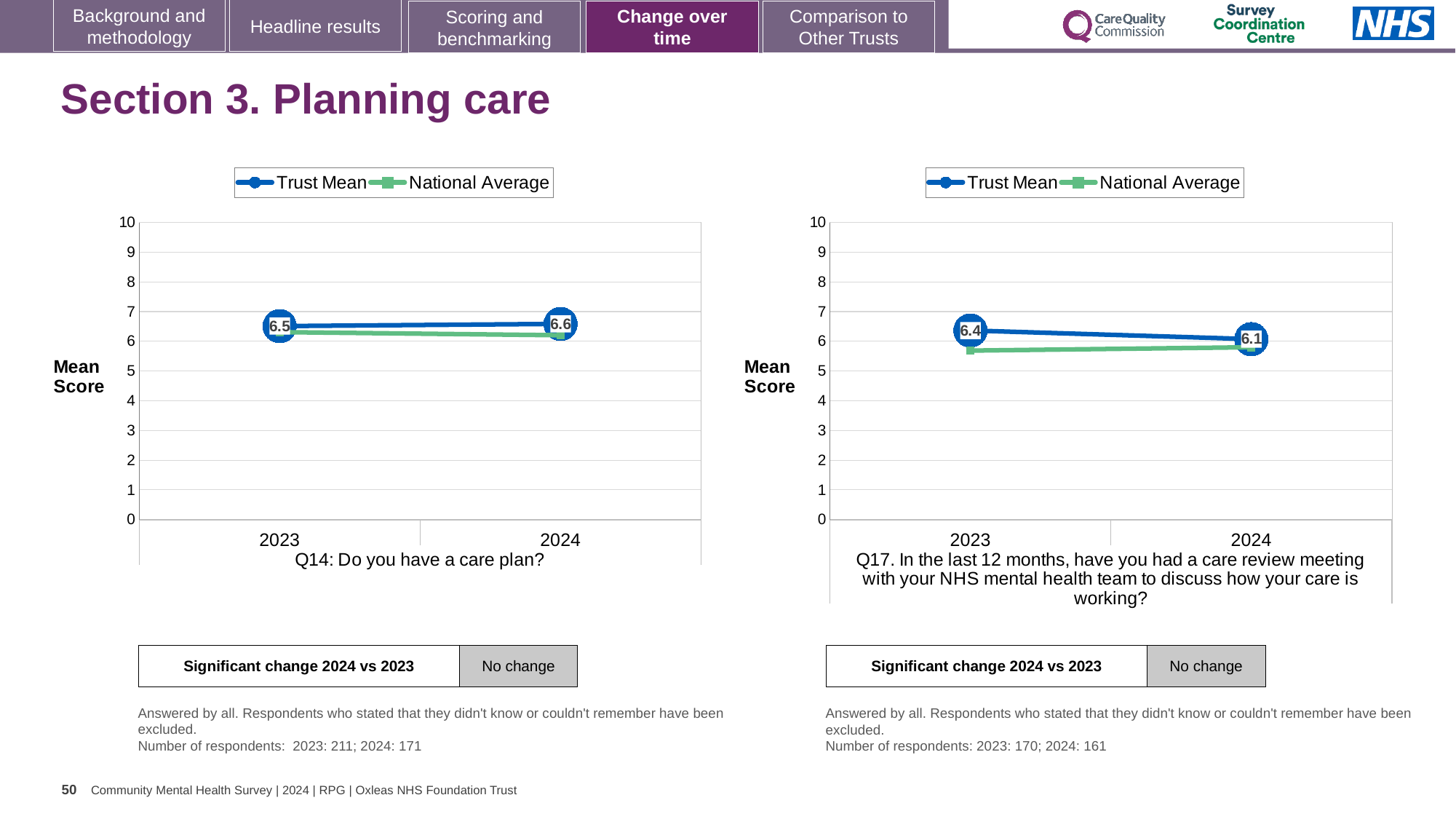
On the Q14 care plan chart, what is the Trust Mean for 2023? 6.5 On the Q17 care review meeting chart, what is the Trust Mean for 2023? 6.4 On the Q17 care review meeting chart, by how much did the Trust Mean change from 2023 to 2024? 0.3 On the Q17 care review meeting chart, which is larger in 2023: the Trust Mean or the National Average? Trust Mean How many series does the legend of the Q17 care review meeting chart list? 2 On the Q17 care review meeting chart, is the National Average for 2023 greater or less than 6? less On the Q17 care review meeting chart, does the Trust Mean rise or fall from 2023 to 2024? fall What kind of chart is the Q14 care plan chart? line chart How many years are plotted on the x axis of the Q14 care plan chart? 2 On the Q17 care review meeting chart, what is the Trust Mean for 2024? 6.1 On the Q14 care plan chart, does the Trust Mean rise or fall from 2023 to 2024? rise On the Q14 care plan chart, what is the Trust Mean for 2024? 6.6